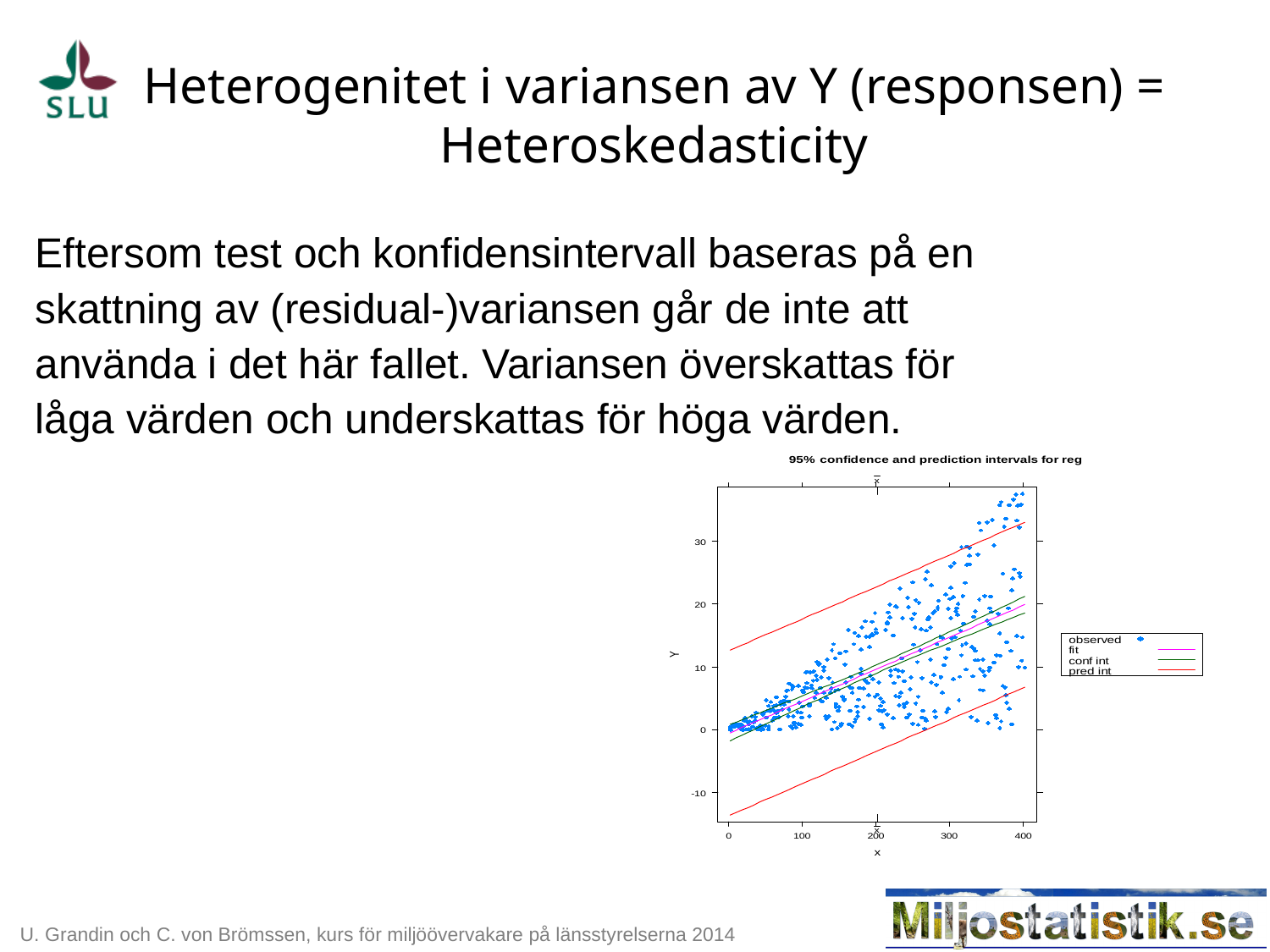
What kind of chart is shown on the slide? scatter plot Does the spread of the observed points around the fit line increase or decrease as x increases? increase How many entries does the legend of the chart list? 4 What is the title of the chart? 95% confidence and prediction intervals for reg What are the four entries listed in the chart's legend? observed, fit, conf int, pred int Do the observed Y values generally rise or fall as x increases? rise